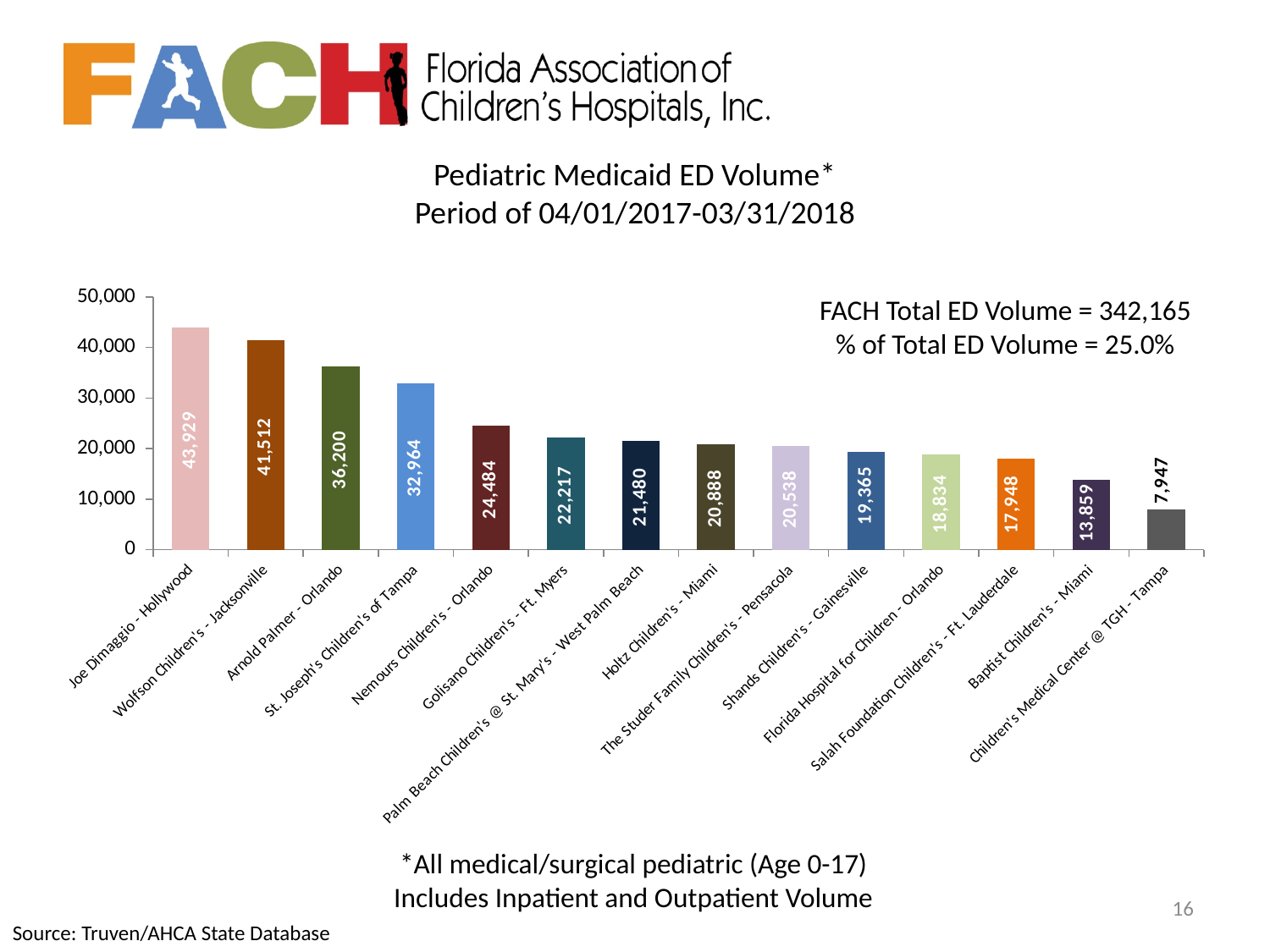
What kind of chart is shown on the slide? Bar chart Which hospital has the highest Pediatric Medicaid ED Volume? Joe Dimaggio - Hollywood What is the value shown for Shands Children's - Gainesville? 19,365 What is the Pediatric Medicaid ED Volume for Joe Dimaggio - Hollywood? 43,929 Which has a larger value: Arnold Palmer - Orlando or St. Joseph's Children's of Tampa? Arnold Palmer - Orlando Do the values rise or fall from left to right across the chart? Fall Which hospital has the lowest Pediatric Medicaid ED Volume? Children's Medical Center @ TGH - Tampa What is the FACH Total ED Volume stated on the slide? 342,165 Is the value for Golisano Children's - Ft. Myers greater or less than 20,000? greater What is the difference between the values for Joe Dimaggio - Hollywood and Wolfson Children's - Jacksonville? 2,417 How many hospitals are shown in the chart? 14 What is the value shown for Nemours Children's - Orlando? 24,484